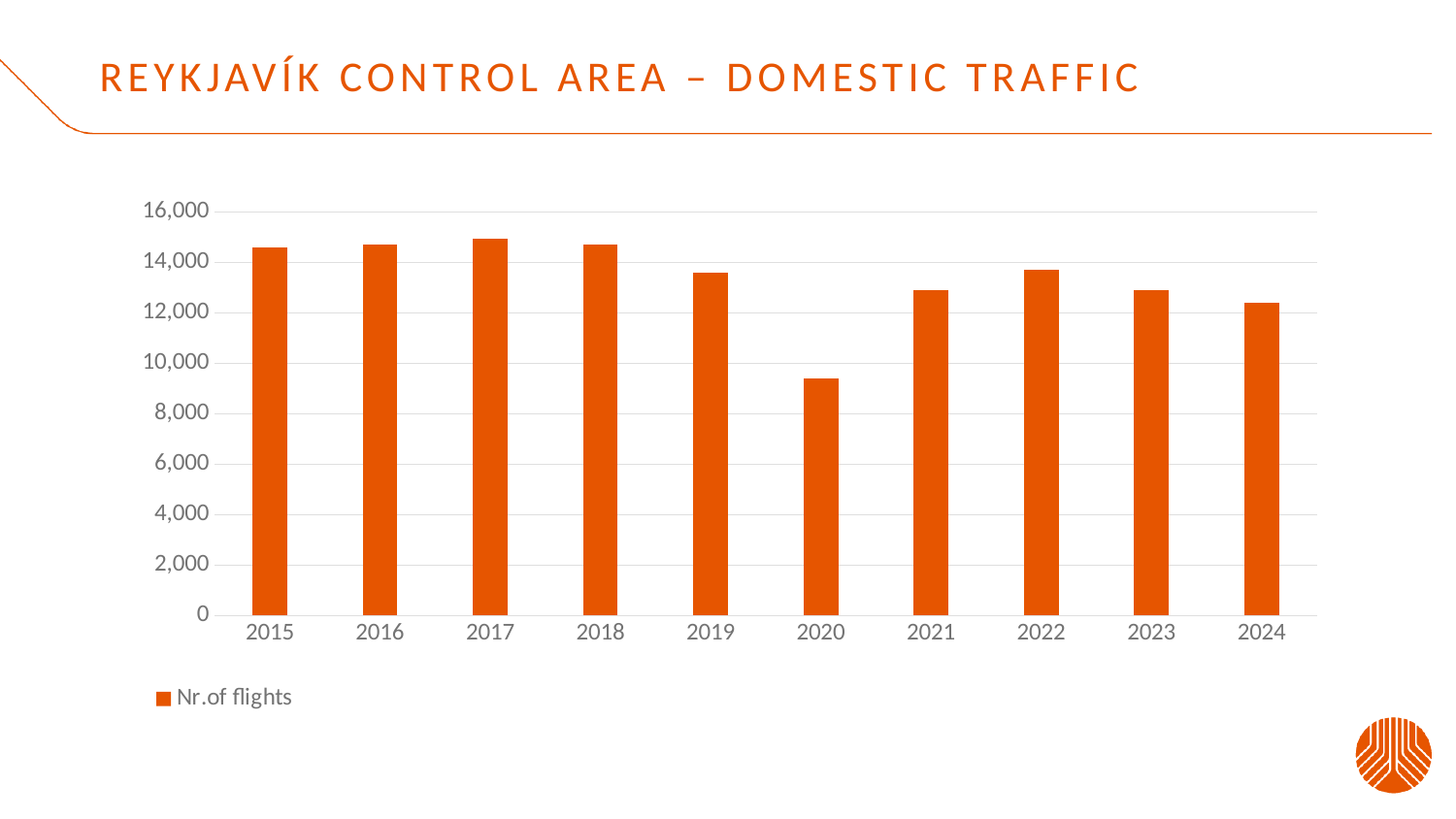
Is the value for 2024 greater or less than 12,000? greater How many series does the legend list? 1 What kind of chart is shown on the slide? bar chart How many years are shown on the x axis of the chart? 10 Is the value for 2020 greater or less than 10,000? less Which year has the lowest number of flights? 2020 Is the value for 2015 greater or less than 14,000? greater Which year has more flights, 2020 or 2021? 2021 What is the name of the series shown in the legend? Nr.of flights Which year has more flights, 2015 or 2024? 2015 Do the values rise or fall from 2018 to 2020? fall